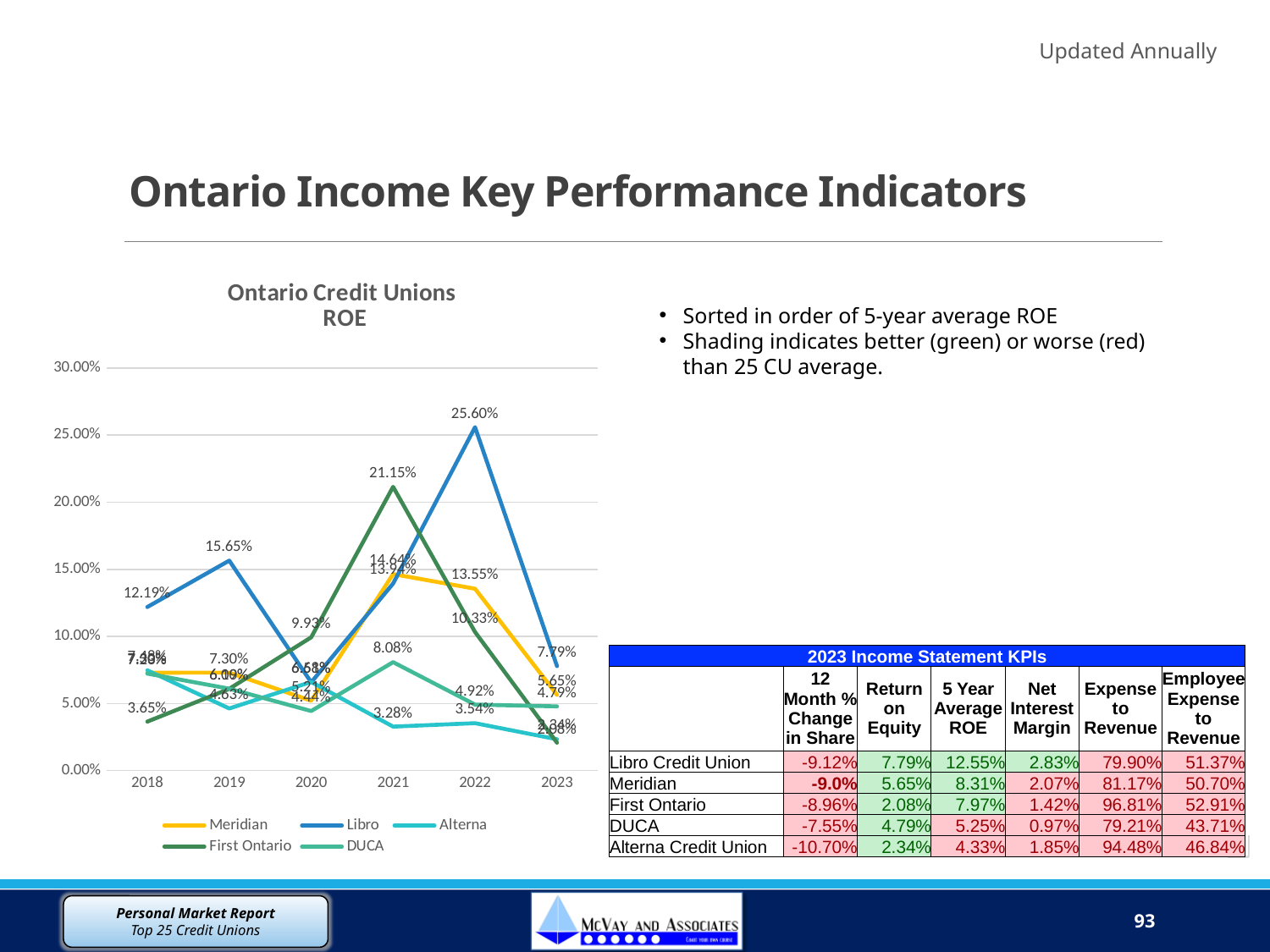
What is the difference between Libro's and Meridian's ROE in 2022 on the Ontario Credit Unions ROE chart? 12.05% What is the ROE value for Libro in 2022 on the Ontario Credit Unions ROE chart? 25.60% Which credit union has the highest ROE in 2022 on the Ontario Credit Unions ROE chart? Libro What is the ROE value for Meridian in 2022 on the Ontario Credit Unions ROE chart? 13.55% On the Ontario Credit Unions ROE chart, which is larger: Libro's 2022 ROE or First Ontario's 2021 ROE? Libro's 2022 ROE What type of chart is the Ontario Credit Unions ROE chart? Line chart What is the ROE value for Libro in 2019 on the Ontario Credit Unions ROE chart? 15.65% How many credit unions are listed in the legend of the Ontario Credit Unions ROE chart? 5 How many years are shown on the x axis of the Ontario Credit Unions ROE chart? 6 On the Ontario Credit Unions ROE chart, is Meridian's 2021 ROE greater or less than 10.00%? greater What is the ROE value for DUCA in 2021 on the Ontario Credit Unions ROE chart? 8.08% What is the ROE value for First Ontario in 2021 on the Ontario Credit Unions ROE chart? 21.15%